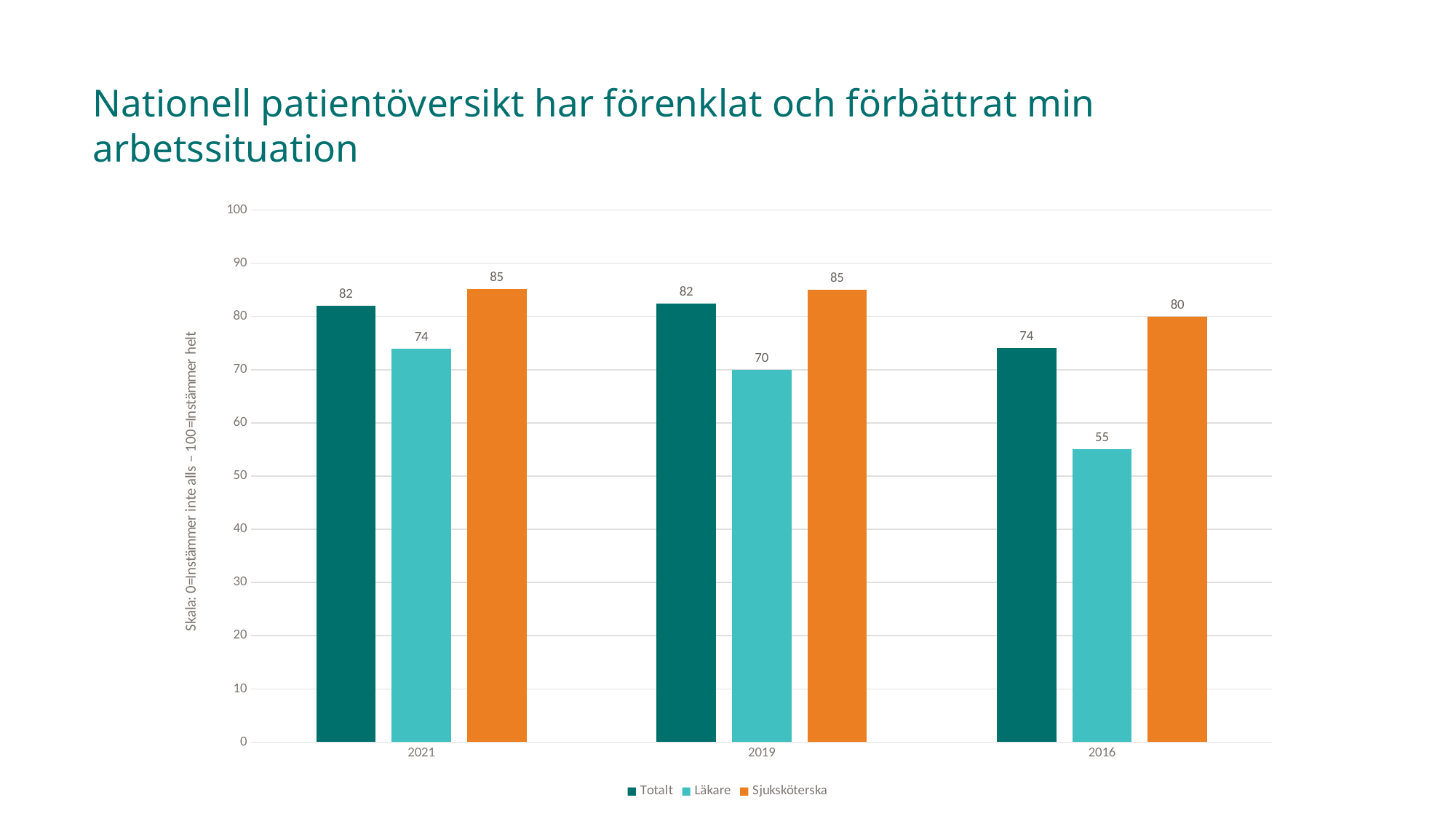
What is the difference between the Sjuksköterska and Läkare values in 2016? 25 How many years are shown on the x axis? 3 What is the value for Läkare in 2016? 55 What kind of chart is shown on the slide? bar chart What is the value for Sjuksköterska in 2021? 85 Which is larger in 2019, the Läkare value or the Totalt value? Totalt How many series does the legend list? 3 Which series has the highest value in 2016? Sjuksköterska What is the value for Totalt in 2019? 82 Is the value for Läkare in 2016 greater or less than 60? less What is the difference between the Totalt values in 2021 and 2016? 8 In which year is the Läkare value lowest? 2016